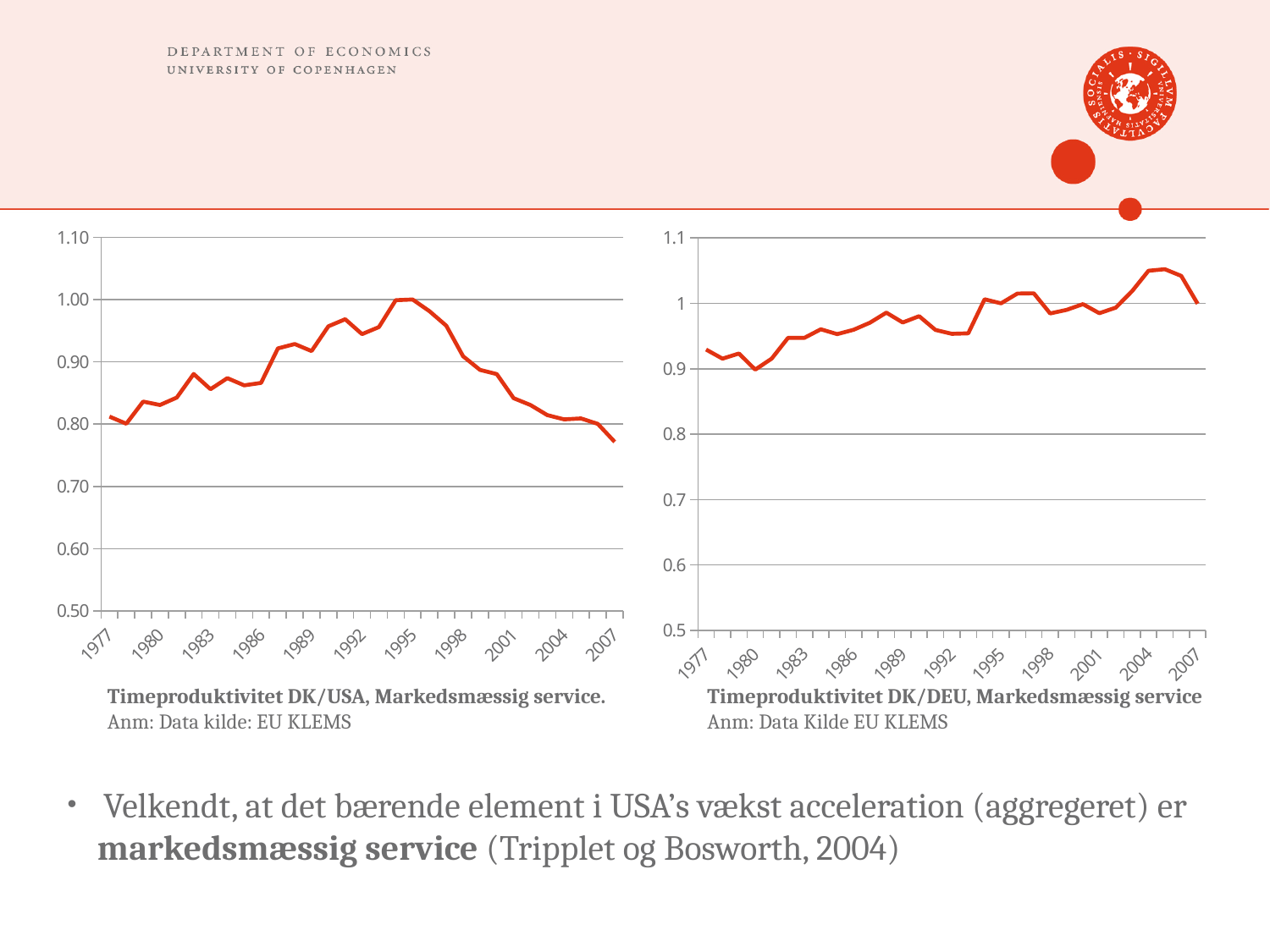
What kind of chart is the left chart, 'Timeproduktivitet DK/USA, Markedsmæssig service'? line chart In the left chart (DK/USA), is the value for 2007 greater or less than 0.80? less In the right chart (DK/DEU), which year has the higher value, 1980 or 2004? 2004 In the left chart (DK/USA), is the value for 1995 greater or less than 0.90? greater In the right chart (DK/DEU), is the value for 2004 greater or less than 1? greater In the left chart (DK/USA), do the values rise or fall between 1995 and 2007? fall What is the title of the right chart? Timeproduktivitet DK/DEU, Markedsmæssig service What kind of chart is the right chart, 'Timeproduktivitet DK/DEU, Markedsmæssig service'? line chart In the left chart (DK/USA), which year has the higher value, 1995 or 2007? 1995 In the right chart (DK/DEU), do the values generally rise or fall between 1977 and 2004? rise